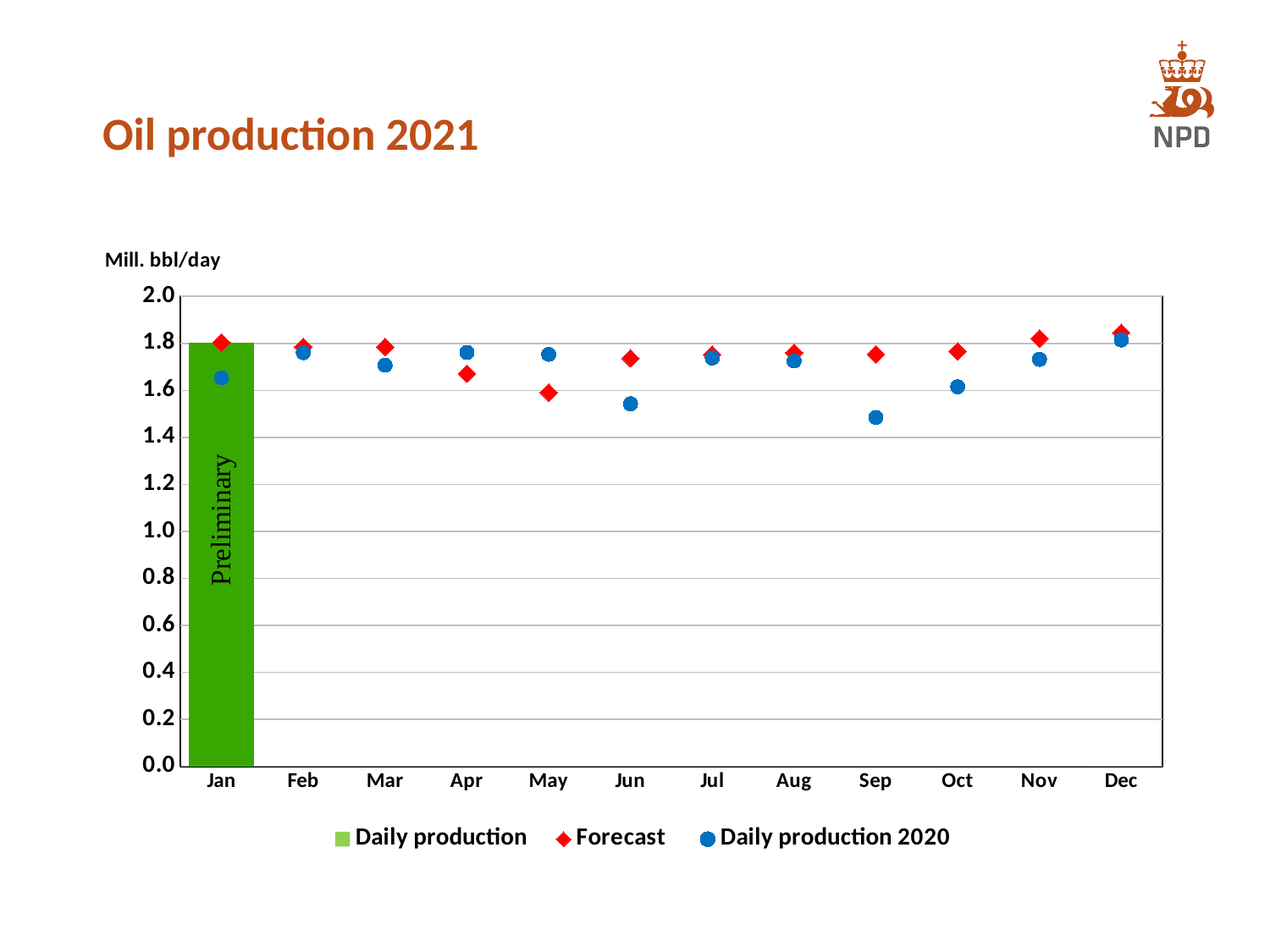
In which month is the Daily production 2020 value lowest? Sep What word is written on the green Jan bar? Preliminary Is the Daily production 2020 value for Sep greater or less than 1.6? less How many months are shown on the x axis? 12 In which month is the Daily production 2020 value highest? Dec How many series does the legend list? 3 In which month is the Forecast value lowest? May In Jun, which is larger: the Forecast or the Daily production 2020 value? Forecast Is the Forecast value for Dec greater or less than 1.8? greater In which month is the Forecast value highest? Dec What unit is shown above the y axis? Mill. bbl/day Do the Daily production 2020 values rise or fall from Sep to Dec? rise